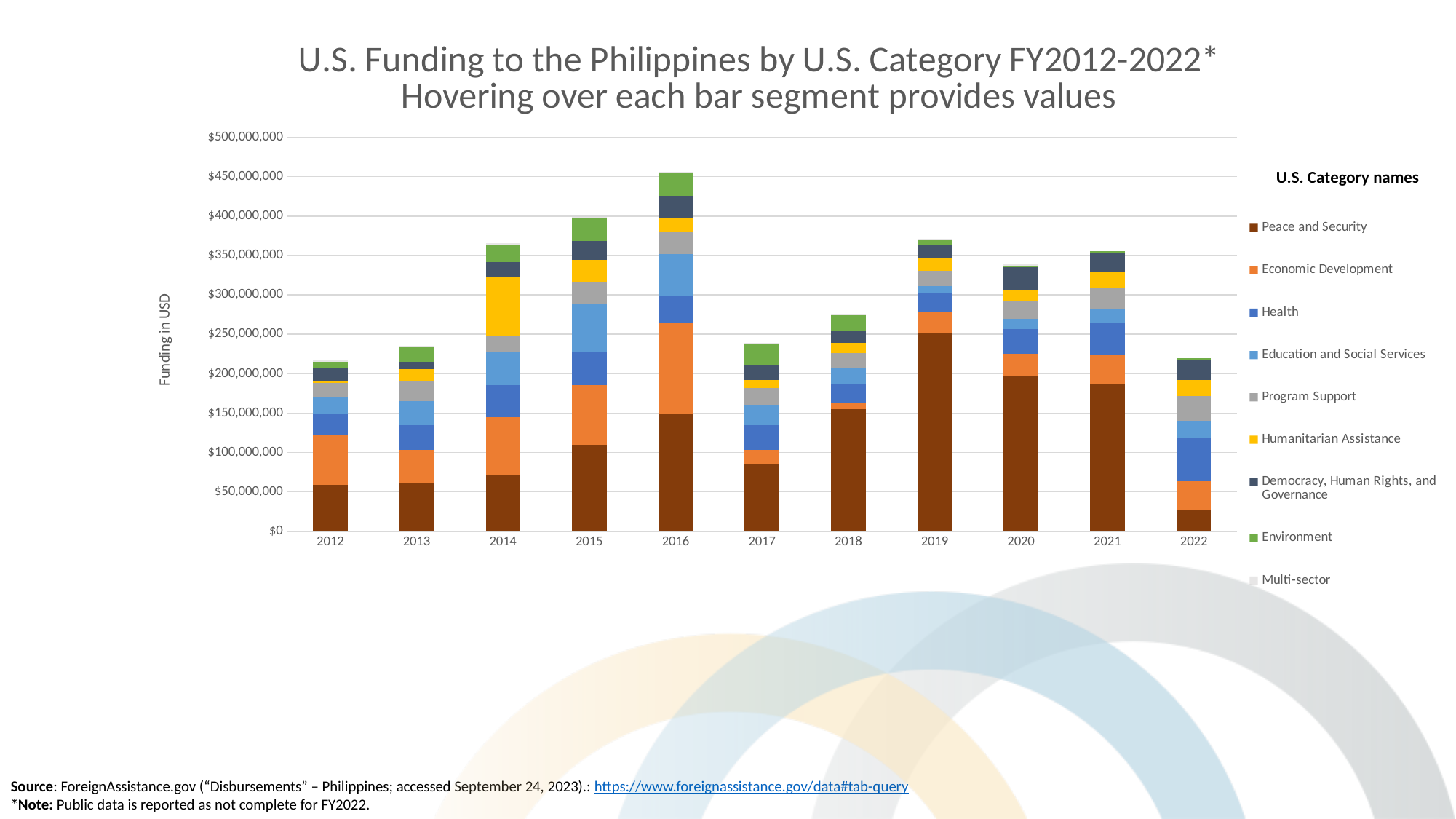
Which year has the larger total funding, 2014 or 2015? 2015 Which fiscal year has the highest total funding? 2016 Which year has the larger total funding, 2019 or 2020? 2019 Is the total funding for 2016 greater or less than $400,000,000? greater Is the total funding for 2012 greater or less than $250,000,000? less What is the label on the vertical axis of the chart? Funding in USD Do total funding values rise or fall from 2012 to 2016? rise In which year is the Peace and Security segment the largest? 2019 Is the total funding for 2019 greater or less than $350,000,000? greater How many fiscal years (bars) are plotted on the chart? 11 What kind of chart is shown on the slide? Stacked bar chart How many U.S. categories does the legend list? 9